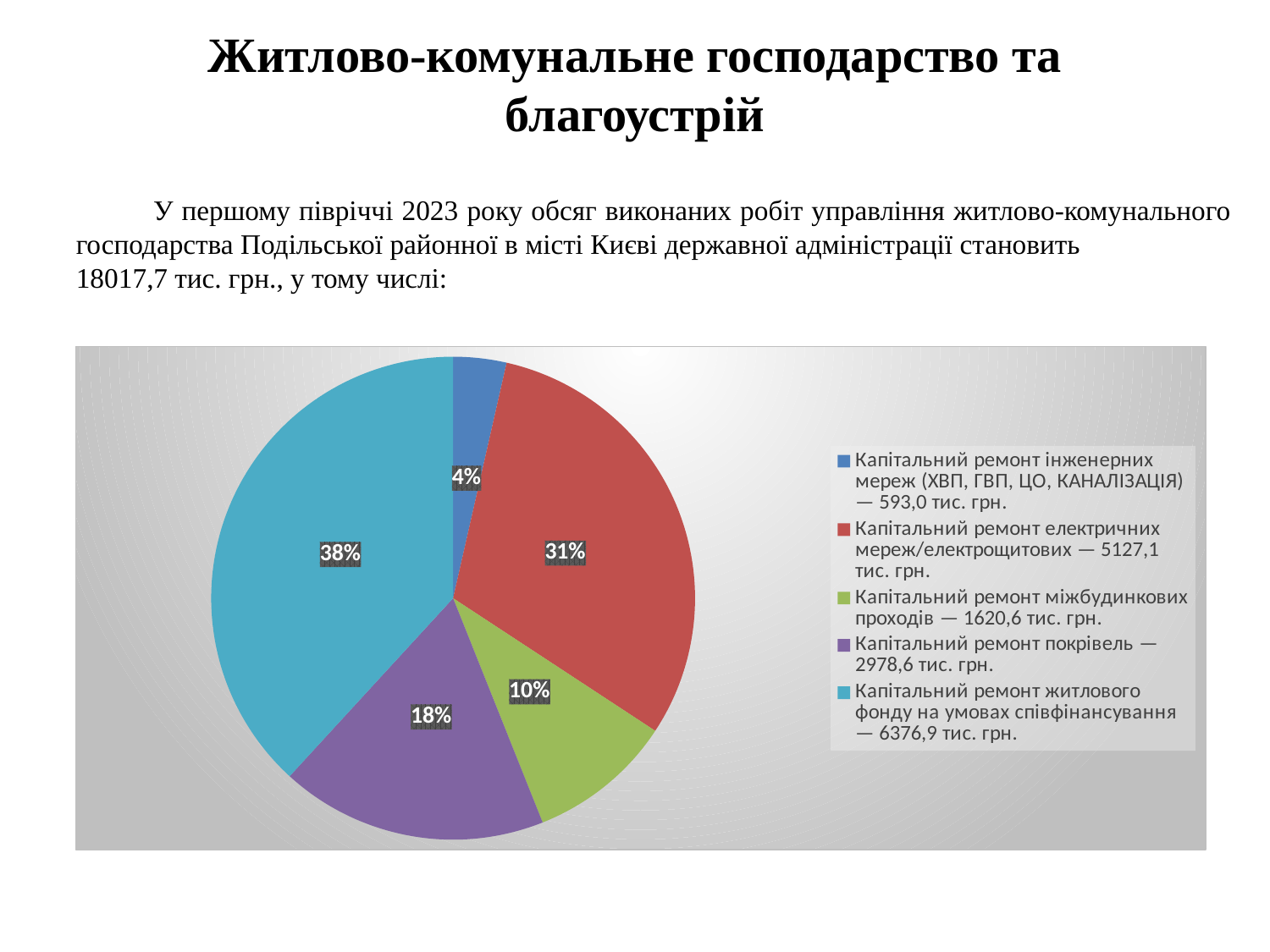
What share of the pie is labelled for "Капітальний ремонт покрівель"? 18% How many slices does the pie chart have? 5 Which category has the smallest slice of the pie? Капітальний ремонт інженерних мереж (ХВП, ГВП, ЦО, КАНАЛІЗАЦІЯ) What kind of chart is shown on the slide? pie chart Which category has the largest slice of the pie? Капітальний ремонт житлового фонду на умовах співфінансування What share of the pie is labelled for "Капітальний ремонт житлового фонду на умовах співфінансування"? 38% Which slice is larger: "Капітальний ремонт покрівель" or "Капітальний ремонт міжбудинкових проходів"? Капітальний ремонт покрівель What is the difference in percentage points between the slice for "Капітальний ремонт житлового фонду на умовах співфінансування" and the slice for "Капітальний ремонт електричних мереж/електрощитових"? 7 percentage points What amount does the legend give for "Капітальний ремонт інженерних мереж (ХВП, ГВП, ЦО, КАНАЛІЗАЦІЯ)"? 593,0 тис. грн. What share of the pie is labelled for "Капітальний ремонт електричних мереж/електрощитових"? 31% What amount does the legend give for "Капітальний ремонт покрівель"? 2978,6 тис. грн.